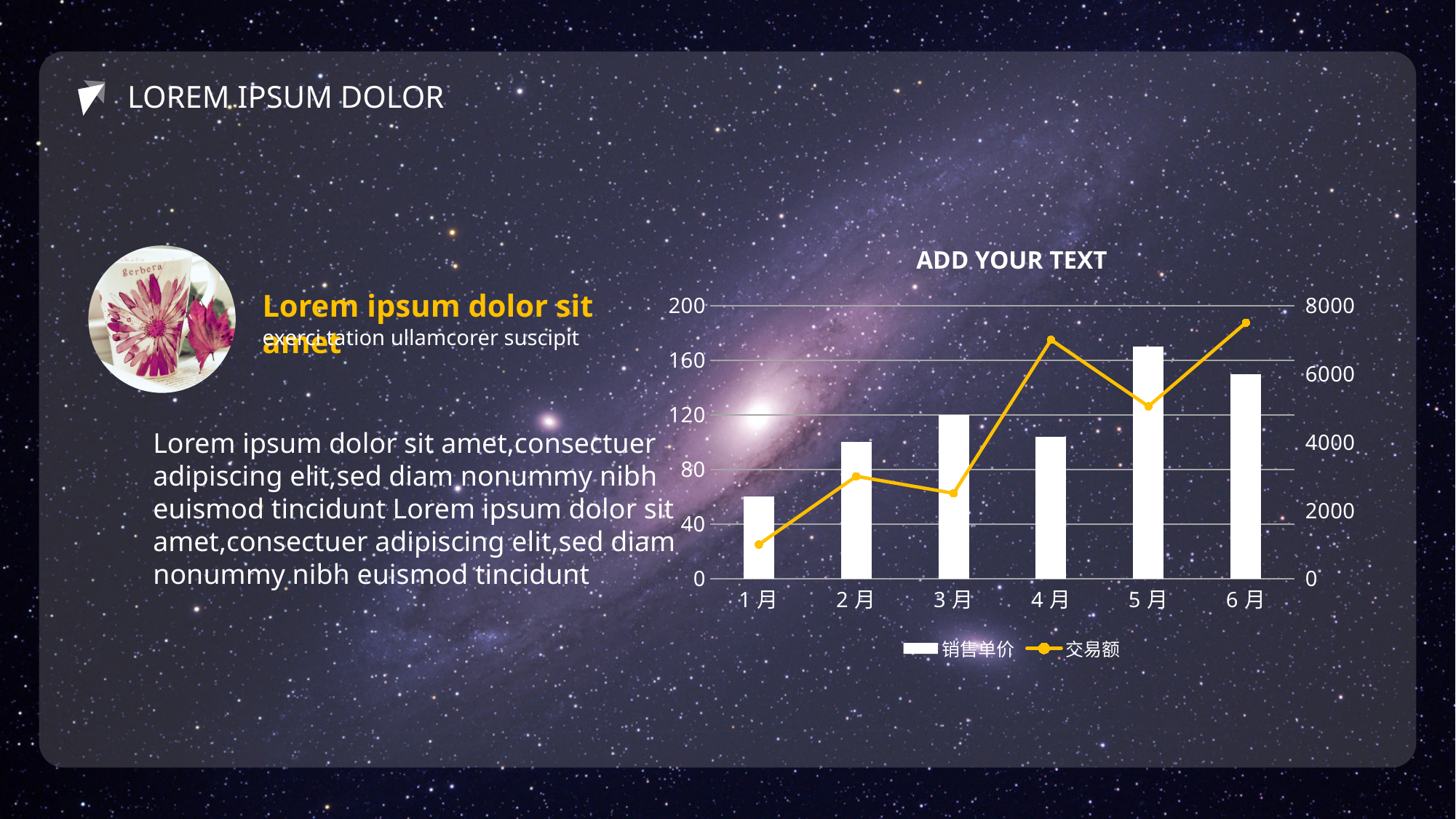
Is the 销售单价 value for 1月 greater or less than 80? less Which series is drawn as a line in the chart? 交易额 Which month has the tallest 销售单价 bar? 5月 In which month does the 交易额 line reach its highest point? 6月 What kind of chart is shown on the slide? A combined bar and line chart What is the title of the chart? ADD YOUR TEXT How many series does the chart legend list? 2 Is the 销售单价 value for 5月 greater or less than 160? greater How many categories are shown on the x axis of the chart? 6 Which month has the shortest 销售单价 bar? 1月 Is the 交易额 value for 4月 greater or less than 6000? greater Which is larger, the 销售单价 bar for 6月 or for 2月? 6月